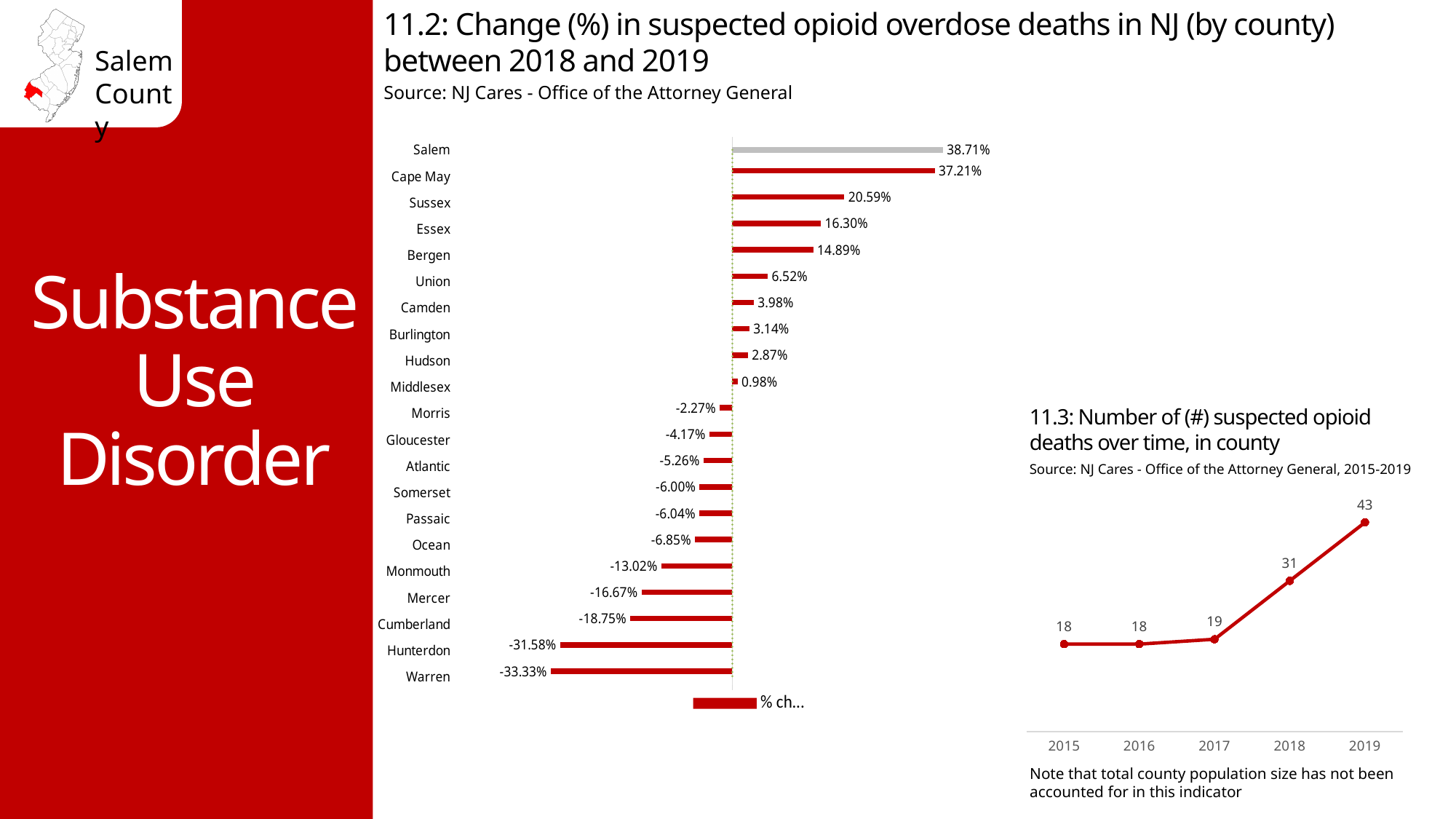
In chart 11.2 (Change (%) in suspected opioid overdose deaths), what is the value for Salem? 38.71% What kind of chart is chart 11.3 (Number of (#) suspected opioid deaths over time)? Line chart In chart 11.2 (Change (%) in suspected opioid overdose deaths), what is the difference between the values for Salem and Cape May? 1.50% In chart 11.2 (Change (%) in suspected opioid overdose deaths), what is the value for Cumberland? -18.75% In chart 11.3 (Number of (#) suspected opioid deaths over time), do the values rise or fall from 2015 to 2019? Rise In chart 11.2 (Change (%) in suspected opioid overdose deaths), which county has the highest value? Salem In chart 11.2 (Change (%) in suspected opioid overdose deaths), which county has the lowest value? Warren In chart 11.3 (Number of (#) suspected opioid deaths over time), what is the value for 2019? 43 In chart 11.3 (Number of (#) suspected opioid deaths over time), what is the difference between the values for 2019 and 2018? 12 In chart 11.2 (Change (%) in suspected opioid overdose deaths), how many counties are shown? 21 In chart 11.2 (Change (%) in suspected opioid overdose deaths), which is larger, the value for Sussex or the value for Essex? Sussex What kind of chart is chart 11.2 (Change (%) in suspected opioid overdose deaths)? Bar chart